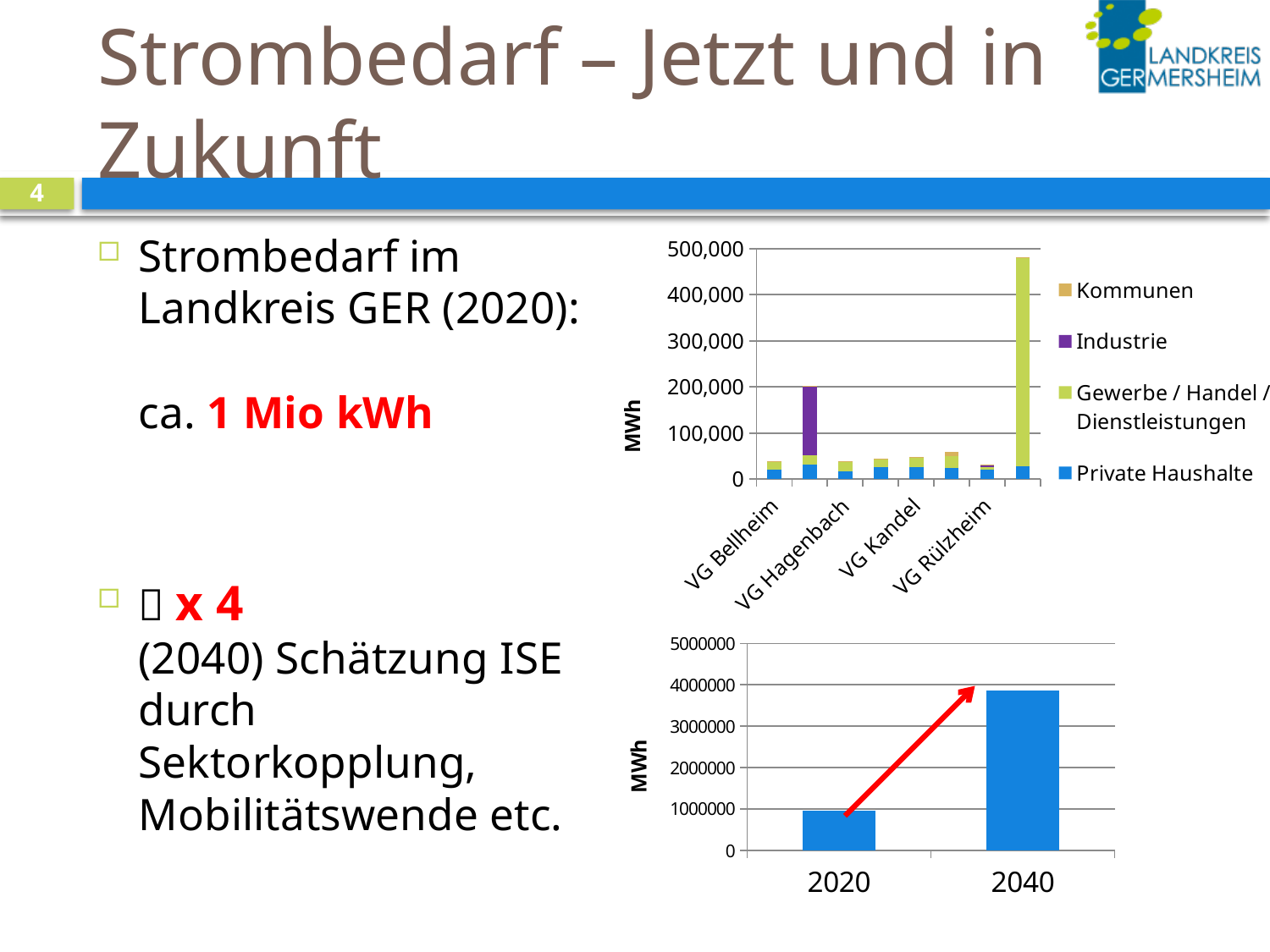
In the bottom chart, do the values rise or fall from 2020 to 2040? rise How many bars are plotted in the top stacked bar chart? 8 In the bottom chart, how many categories are shown on the x axis? 2 In the bottom chart, which is larger, the value for 2020 or the value for 2040? 2040 In the bottom chart, which year has the lower value? 2020 How many series does the legend of the top stacked bar chart list? 4 What kind of chart is the bottom chart showing 2020 and 2040? bar chart What is the y-axis label of the top stacked bar chart? MWh In the bottom chart, which year has the higher value? 2040 In the bottom chart, is the value for 2020 greater or less than 2000000? less In the top stacked bar chart, which series is shown in purple? Industrie In the bottom chart, is the value for 2040 greater or less than 3000000? greater